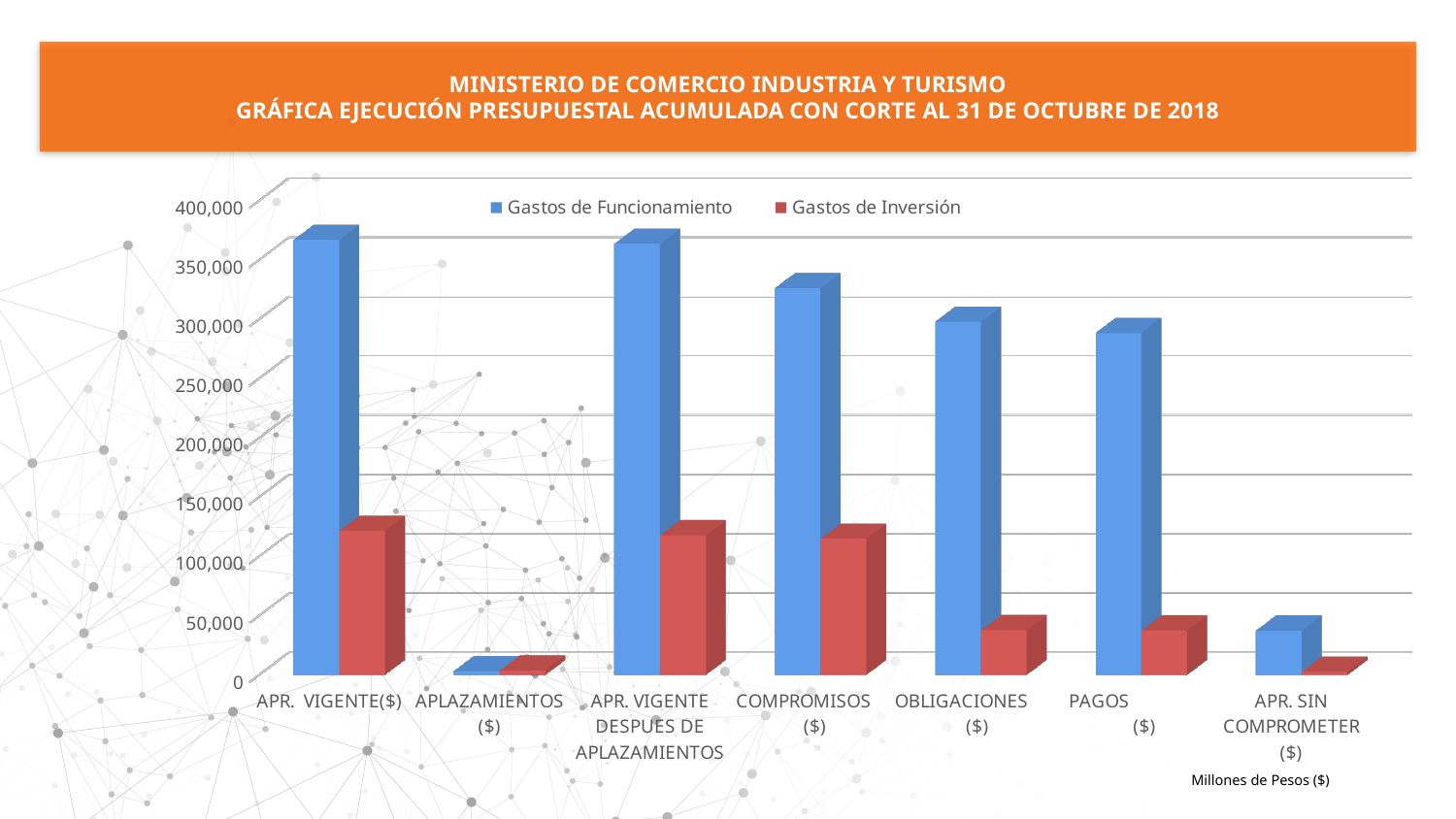
What unit is indicated below the chart for the values? Millones de Pesos ($) Which colour represents Gastos de Inversión in the chart? Red How many series does the chart legend list? 2 What kind of chart is shown on the slide? Bar chart Which category has the lowest value for Gastos de Funcionamiento? APLAZAMIENTOS ($) Is the Gastos de Funcionamiento value for COMPROMISOS ($) greater or less than 300,000? greater Is the Gastos de Inversión value for OBLIGACIONES ($) greater or less than 100,000? less Is the Gastos de Funcionamiento value for APR. SIN COMPROMETER ($) greater or less than 100,000? less How many categories are shown along the x axis of the chart? 7 For COMPROMISOS ($), which series has the larger value, Gastos de Funcionamiento or Gastos de Inversión? Gastos de Funcionamiento